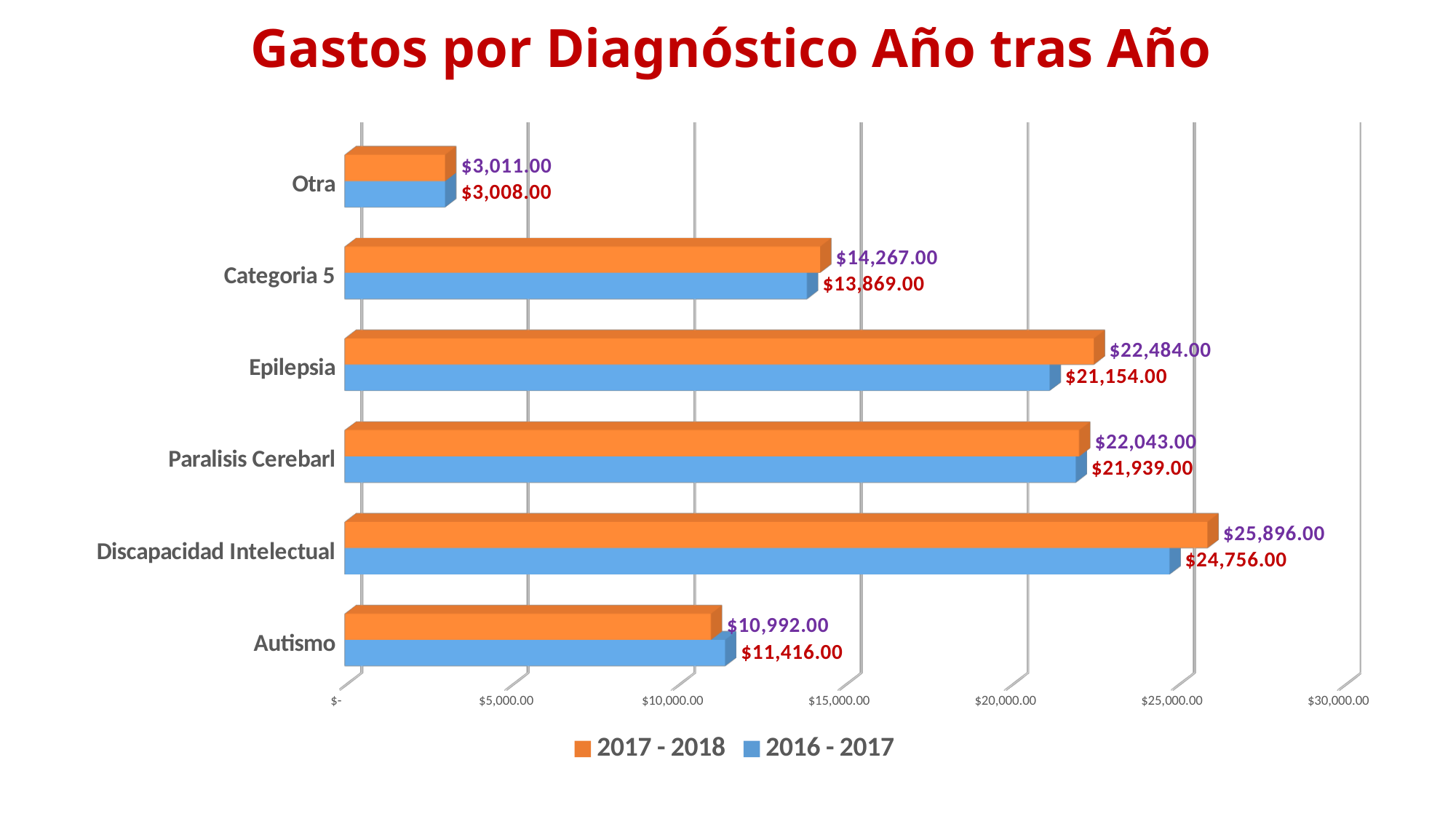
Which category has the highest 2017 - 2018 value? Discapacidad Intelectual What is the 2016 - 2017 value for Otra? $3,008.00 Which is larger for Autismo, the 2017 - 2018 value or the 2016 - 2017 value? 2016 - 2017 What is the 2016 - 2017 value for Epilepsia? $21,154.00 How many series does the legend list? 2 What is the title of the chart? Gastos por Diagnóstico Año tras Año What is the 2017 - 2018 value for Autismo? $10,992.00 What kind of chart is shown on the slide? Bar chart How many categories are shown on the chart? 6 Which category has the lowest 2016 - 2017 value? Otra What is the difference between the 2017 - 2018 and 2016 - 2017 values for Epilepsia? $1,330.00 What is the 2017 - 2018 value for Discapacidad Intelectual? $25,896.00